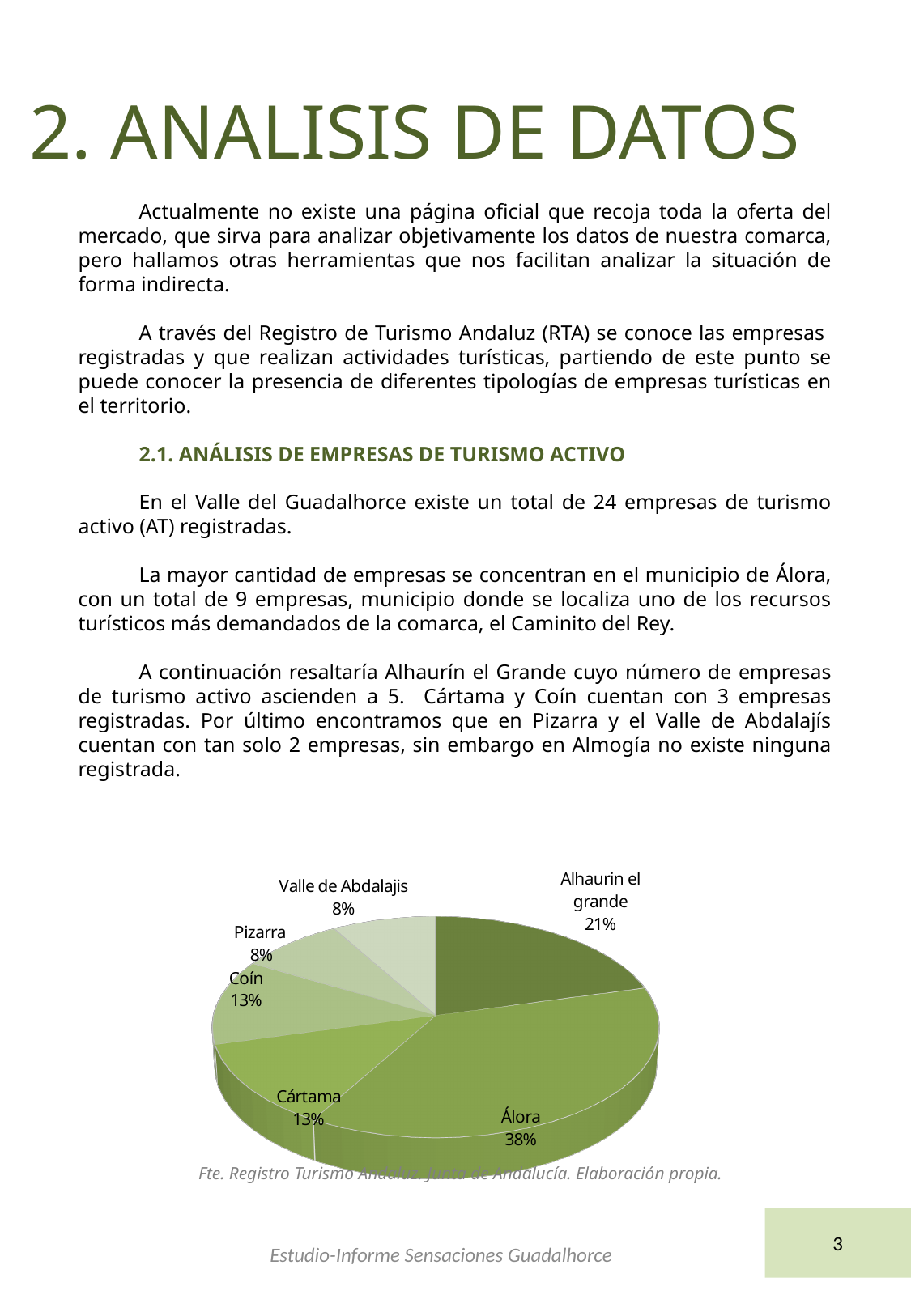
What share of the pie does Álora have? 38% What kind of chart is shown on the slide? pie chart What share of the pie does Pizarra have? 8% What share of the pie does Cártama have? 13% Which is larger in the pie chart, Alhaurin el grande or Coín? Alhaurin el grande What is the difference in percentage points between Cártama and Pizarra? 5 Which municipality has the largest slice of the pie chart? Álora What is the difference in percentage points between Álora and Alhaurin el grande? 17 What source is cited below the pie chart? Fte. Registro Turismo Andaluz. Junta de Andalucía. Elaboración propia. How many slices does the pie chart have? 6